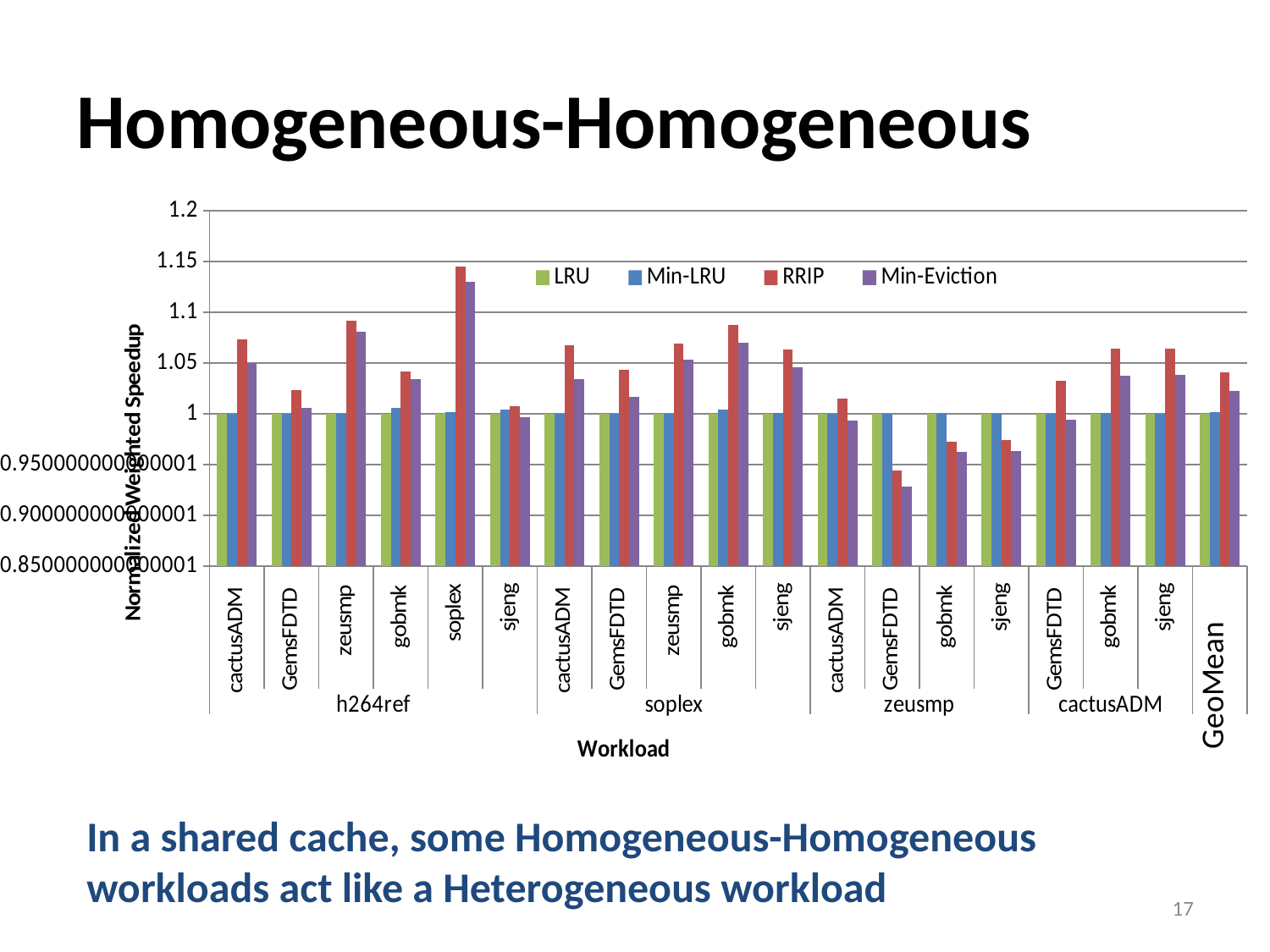
Which workload has the highest RRIP bar? soplex (in the h264ref group) Which workload has the lowest Min-Eviction bar? GemsFDTD (in the zeusmp group) How many sub-workloads are plotted in the h264ref group? 6 Is the RRIP value for soplex in the h264ref group greater or less than 1.1? greater What is the label of the vertical axis? Normalized Weighted Speedup What are the four series named in the legend? LRU, Min-LRU, RRIP, Min-Eviction Is the Min-Eviction value for GemsFDTD in the zeusmp group greater or less than 0.95? less What kind of chart is shown on the slide? bar chart How many series does the legend list? 4 Is the RRIP value for GeoMean greater or less than 1? greater For cactusADM in the h264ref group, which is larger: the RRIP bar or the Min-Eviction bar? RRIP What is the LRU value for the soplex workload in the h264ref group? 1